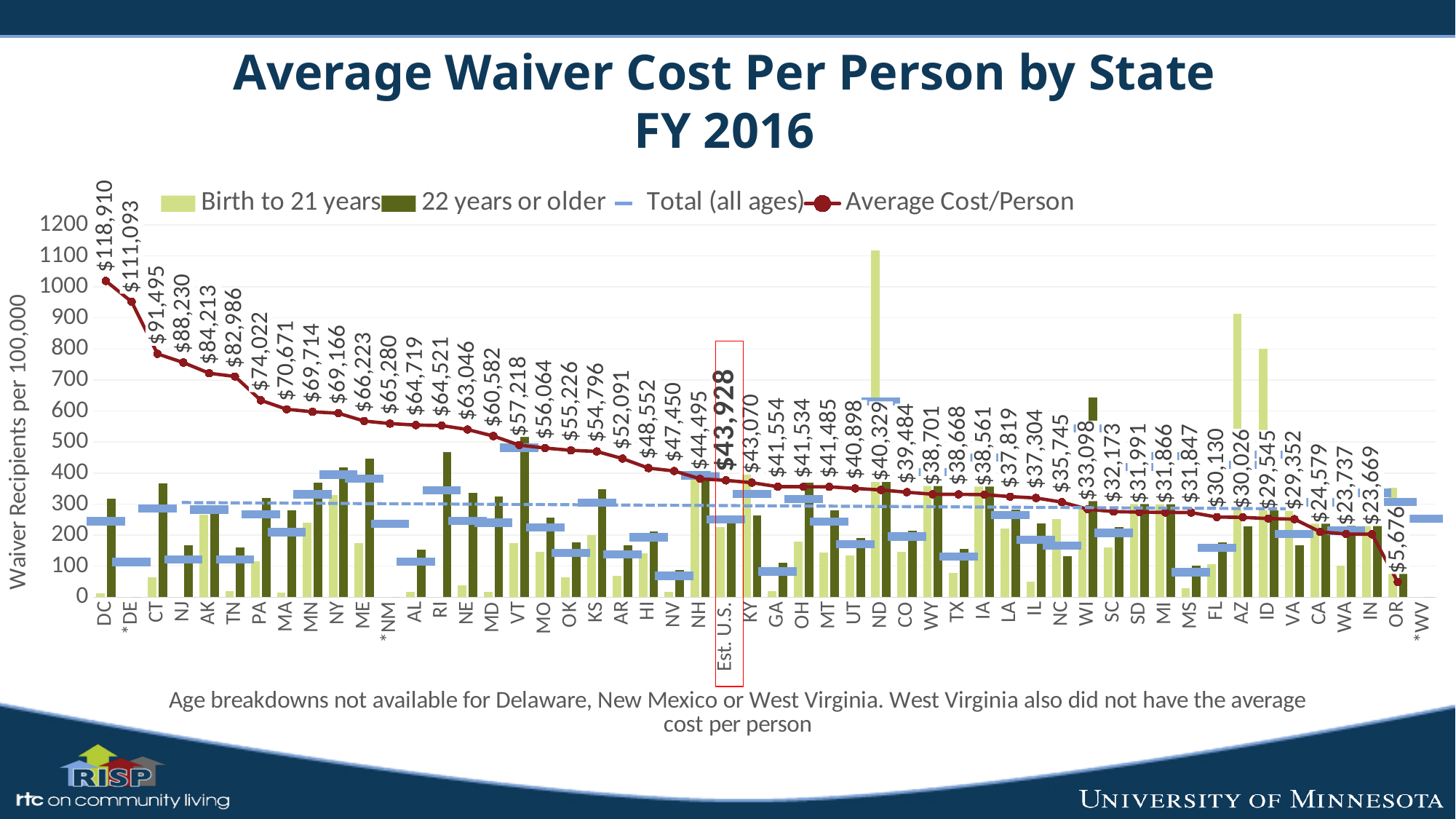
Is the Birth to 21 years value for ND greater or less than 1000? greater Which state has the lowest Average Cost/Person shown? OR What is the Average Cost/Person for OR? $5,676 What is the difference in Average Cost/Person between DC and DE? $7,817 What is the Average Cost/Person for DC? $118,910 Which has a higher Average Cost/Person, CT or NJ? CT What is the label of the y axis? Waiver Recipients per 100,000 Is the Birth to 21 years value for AZ greater or less than 800? greater Which state has the highest Average Cost/Person? DC How many series does the legend list? 4 Does the Average Cost/Person line rise or fall from left to right along the x axis? fall What is the Average Cost/Person for the Est. U.S. category? $43,928